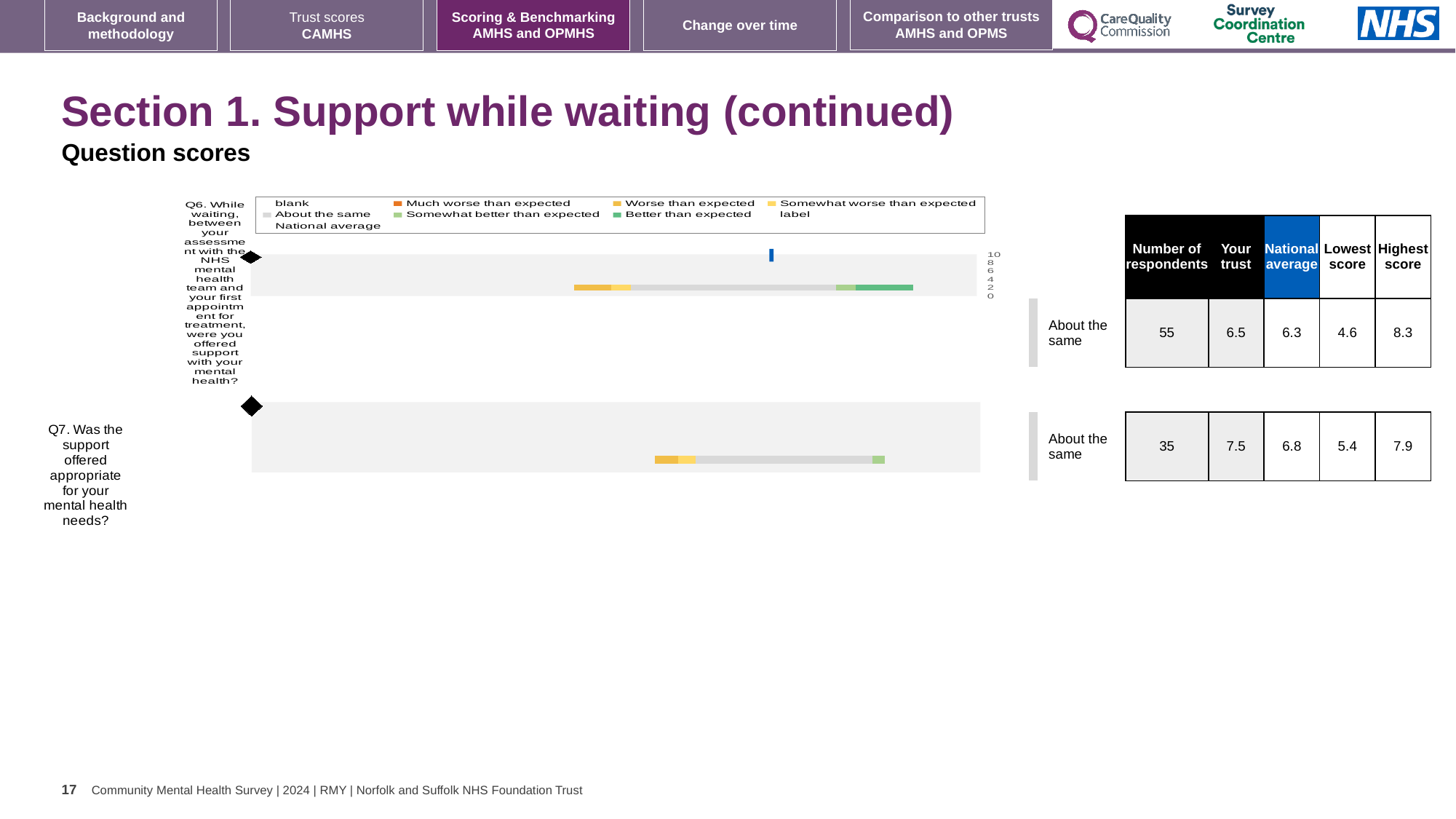
What kind of chart is used to show the question scores on this slide? bar chart Which question has the higher 'Your trust' score, Q6 or Q7? Q7 What is the highest score shown for Q6? 8.3 How many respondents answered Q7? 35 What is the difference between the trust score and the national average for Q7? 0.7 What is the national average score for Q7 (was the support offered appropriate)? 6.8 What is the 'Your trust' score for Q6 (support while waiting)? 6.5 How many questions (categories) are plotted in the chart? 2 How many entries does the chart legend list? 9 What is the difference between the highest and lowest scores for Q6? 3.7 What benchmark category is shown next to the bar for Q6? About the same What colour represents 'Better than expected' in the legend? green